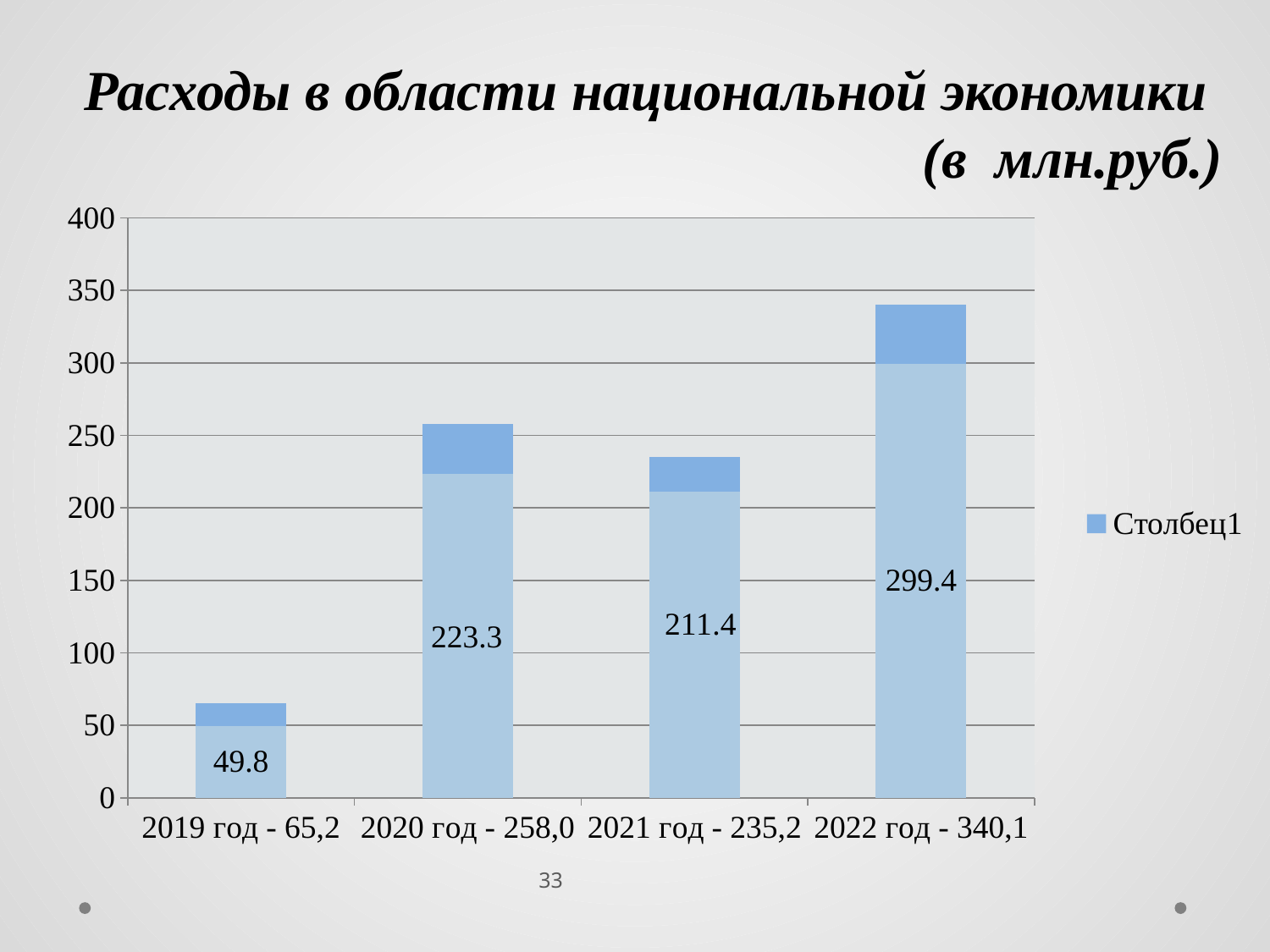
How many entries does the legend list? 1 Is the top of the bar for 2019 год greater or less than 100? less Which year has the shortest bar? 2019 год What is the data label on the lower segment of the bar for 2022 год? 299.4 What is the data label on the lower segment of the bar for 2021 год? 211.4 What is the difference between the labelled values for 2022 год (299.4) and 2019 год (49.8)? 249.6 What is the data label on the lower segment of the bar for 2019 год? 49.8 What type of chart is shown on the slide? bar chart How many bars (years) are shown in the chart? 4 Which year has the tallest bar? 2022 год Which labelled value is larger: 2020 год (223.3) or 2021 год (211.4)? 2020 год (223.3) Is the top of the bar for 2022 год greater or less than 300? greater